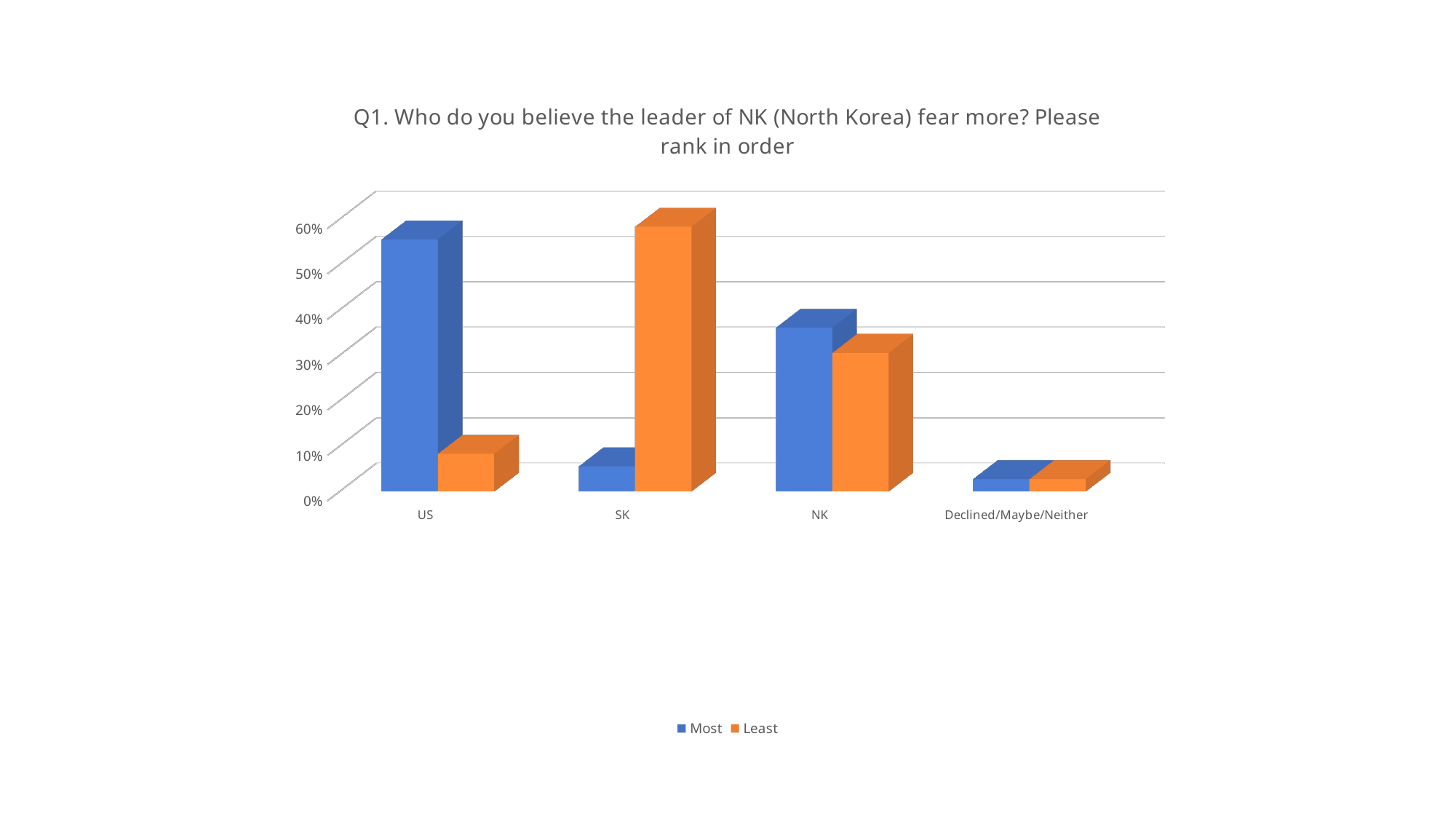
What are the two series named in the legend? Most and Least Which category has the highest value for the Most series? US Is the value for US in the Most series greater or less than 50%? greater Is the value for US in the Least series greater or less than 20%? less Which category has the lowest value for the Least series? Declined/Maybe/Neither How many series does the legend list? 2 What kind of chart is shown on the slide? bar chart For US, which series has the larger value, Most or Least? Most For SK, which series has the larger value, Most or Least? Least Is the value for SK in the Most series greater or less than 10%? less Which category has the highest value for the Least series? SK How many categories are shown on the x axis? 4